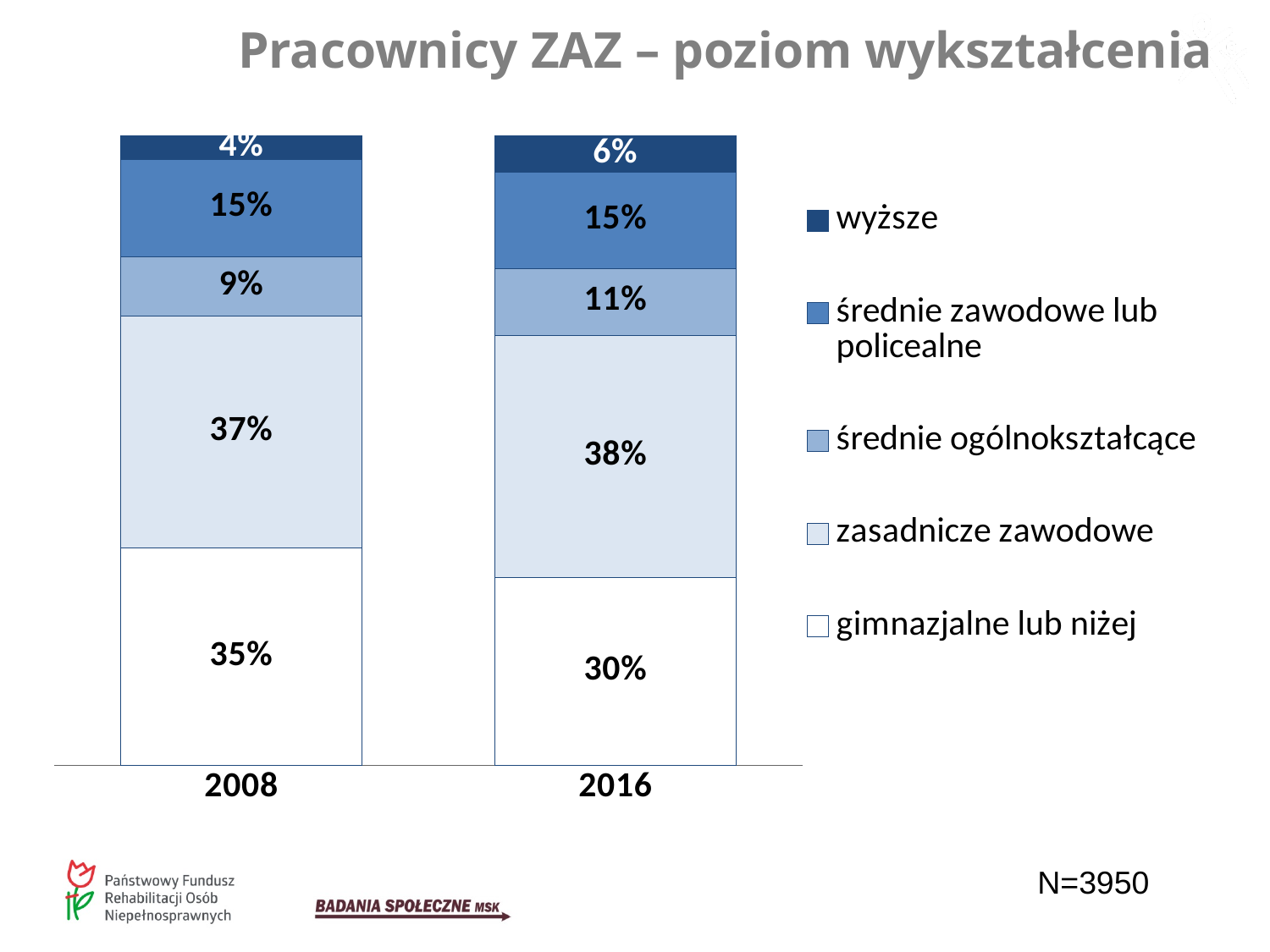
Which education level has the largest share in 2016? zasadnicze zawodowe What is the title of the chart? Pracownicy ZAZ – poziom wykształcenia How many categories (years) are shown on the x axis? 2 What is the difference between the 'gimnazjalne lub niżej' values for 2008 and 2016? 5% How many series does the legend list? 5 Which education level has the smallest share in 2008? wyższe What is the value for 'gimnazjalne lub niżej' in 2016? 30% What is the value for 'wyższe' in 2016? 6% What is the value for 'średnie ogólnokształcące' in 2008? 9% What kind of chart is shown on the slide? stacked bar chart Which is larger: 'średnie ogólnokształcące' in 2008 or in 2016? 2016 What is the value for 'zasadnicze zawodowe' in 2008? 37%